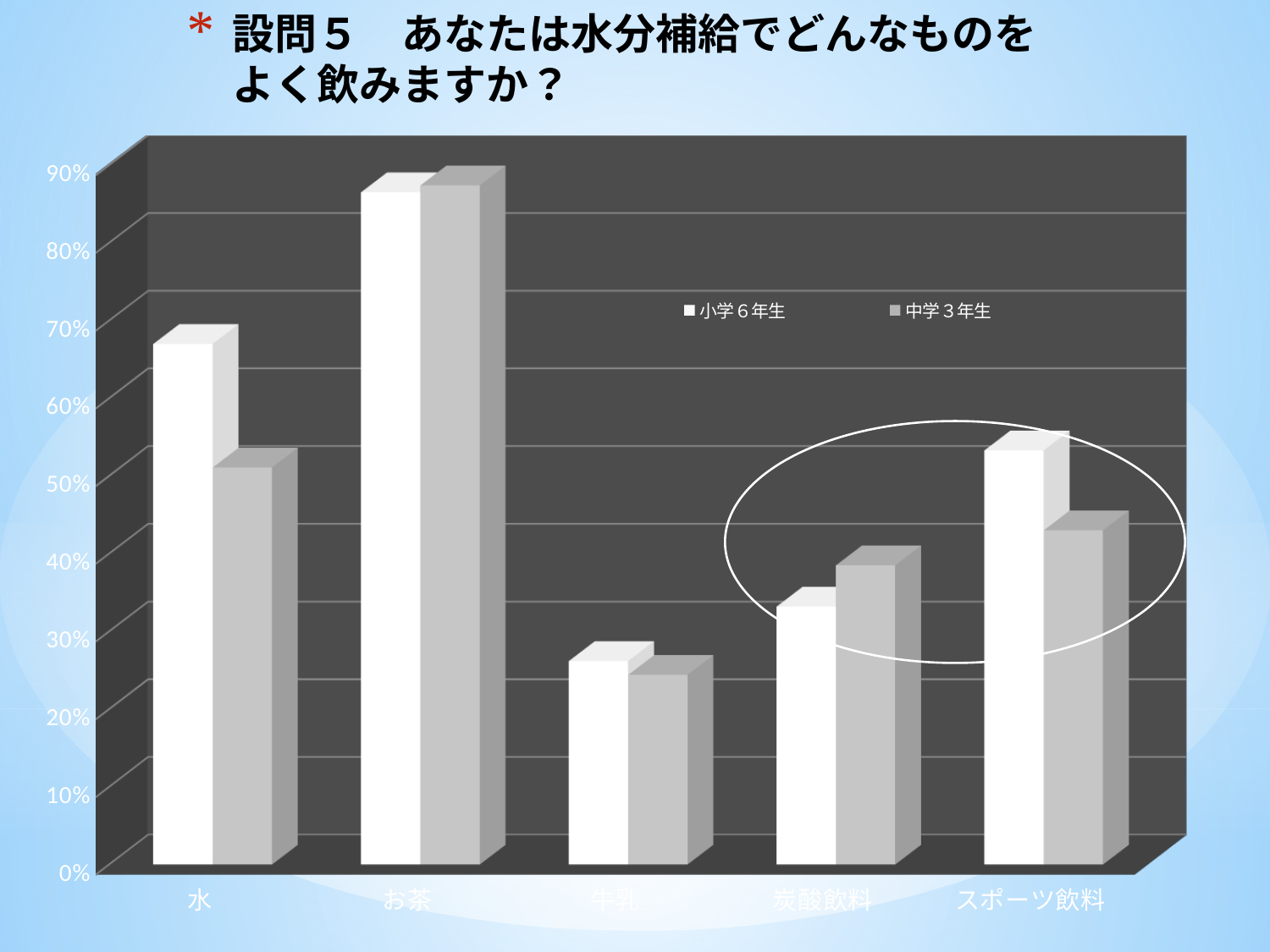
Which category has the highest value for 小学６年生? お茶 For 水, which series has the larger value, 小学６年生 or 中学３年生? 小学６年生 Which category has the lowest value for 小学６年生? 牛乳 How many drink categories are shown on the x axis? 5 What are the two series names listed in the legend? 小学６年生 and 中学３年生 Is the value for 小学６年生 in 水 greater or less than 60%? greater For 炭酸飲料, which series has the larger value, 小学６年生 or 中学３年生? 中学３年生 Is the value for 中学３年生 in スポーツ飲料 greater or less than 50%? less How many series does the legend list? 2 What kind of chart is shown on the slide? bar chart Is the value for 小学６年生 in お茶 greater or less than 80%? greater Which category has the lowest value for 中学３年生? 牛乳